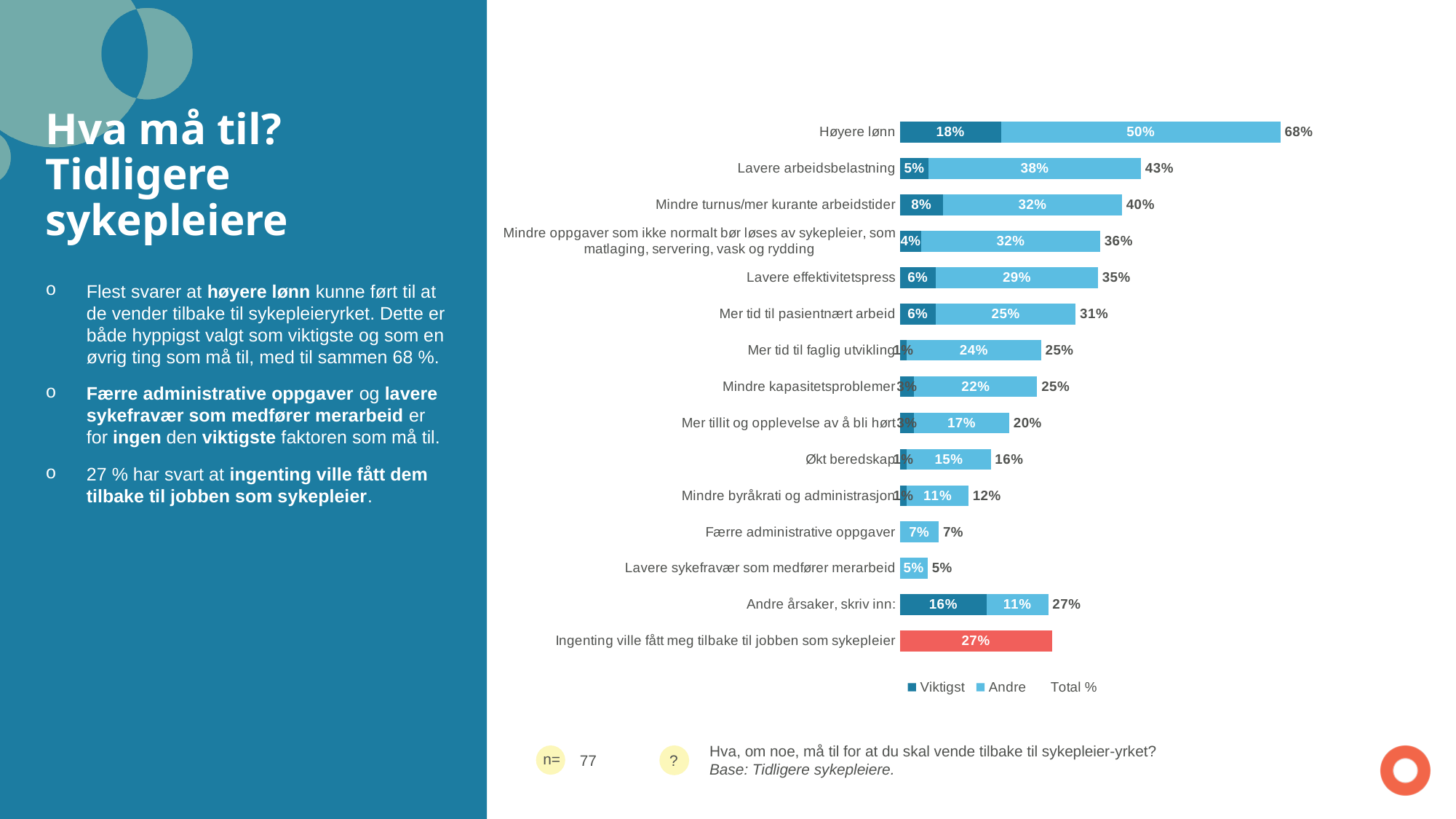
What is the "Viktigst" value for "Mindre turnus/mer kurante arbeidstider"? 8% Which category has the highest total percentage? Høyere lønn Which category has the lowest total percentage? Lavere sykefravær som medfører merarbeid How many categories are shown on the chart? 15 How many entries does the legend list? 3 What is the total of the stacked bar for "Mer tid til pasientnært arbeid"? 31% Which has a larger "Viktigst" value: "Høyere lønn" or "Andre årsaker, skriv inn:"? Høyere lønn What is the "Andre" value for "Lavere arbeidsbelastning"? 38% What is the total percentage shown for "Høyere lønn"? 68% What value is shown for "Ingenting ville fått meg tilbake til jobben som sykepleier"? 27% What is the difference between the total for "Høyere lønn" and the total for "Lavere arbeidsbelastning"? 25% What kind of chart is shown on the slide? Stacked bar chart